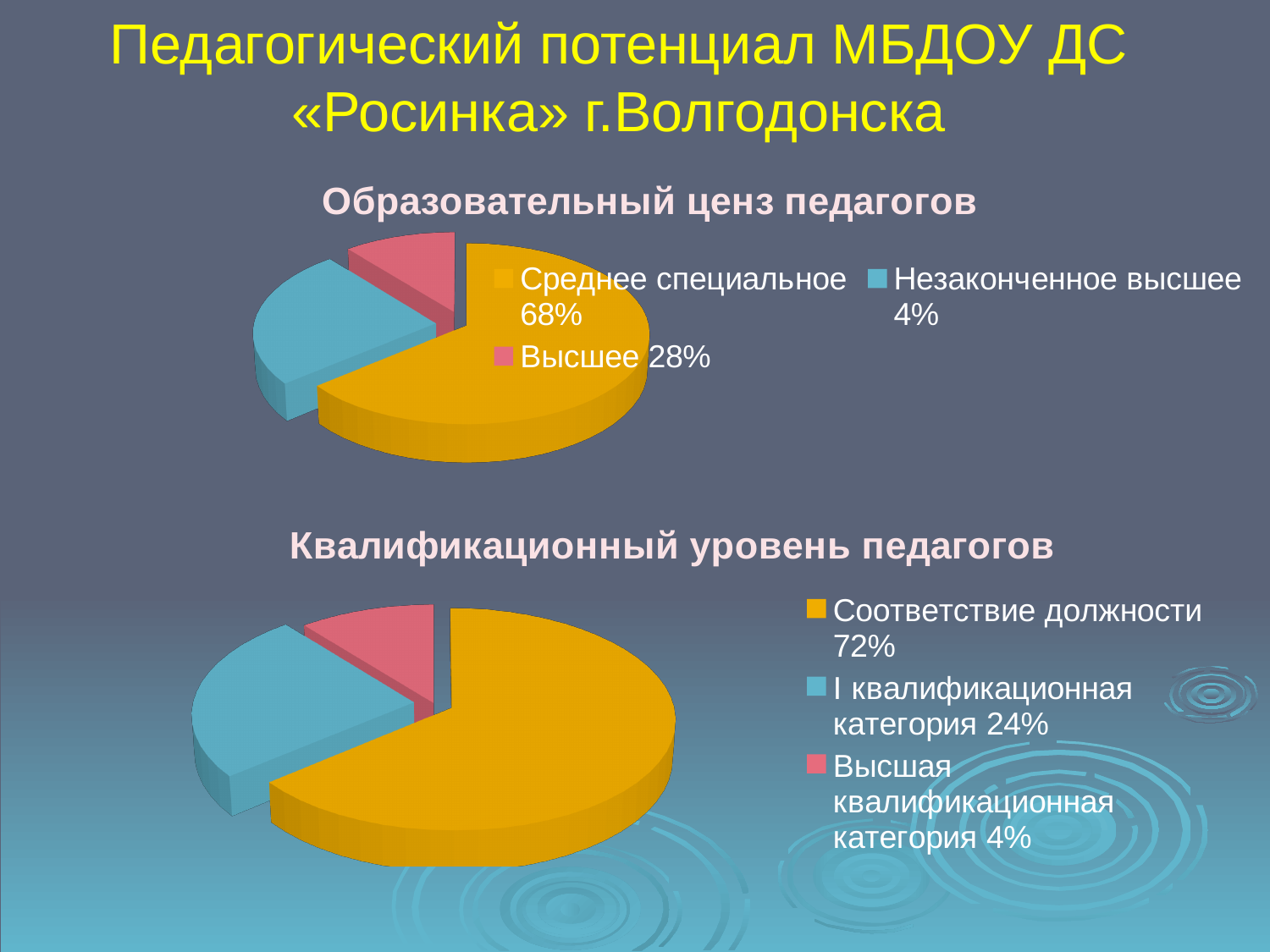
In the chart "Образовательный ценз педагогов", which category has the largest share? Среднее специальное In the chart "Образовательный ценз педагогов", what share of teachers have "Среднее специальное" education? 68% How many categories does the legend of "Образовательный ценз педагогов" list? 3 In the chart "Квалификационный уровень педагогов", which colour represents "Соответствие должности"? Yellow What type of chart is used for "Образовательный ценз педагогов"? Pie chart In the chart "Образовательный ценз педагогов", what share is shown for "Незаконченное высшее"? 4% In the chart "Квалификационный уровень педагогов", what share is shown for "Высшая квалификационная категория"? 4% In the chart "Образовательный ценз педагогов", what share of teachers have "Высшее" education? 28% In the chart "Квалификационный уровень педагогов", what share is shown for "I квалификационная категория"? 24% In the chart "Квалификационный уровень педагогов", what share is shown for "Соответствие должности"? 72% In the chart "Квалификационный уровень педагогов", which category has the smallest share? Высшая квалификационная категория In the chart "Квалификационный уровень педагогов", what is the difference between the shares of "Соответствие должности" and "I квалификационная категория"? 48%